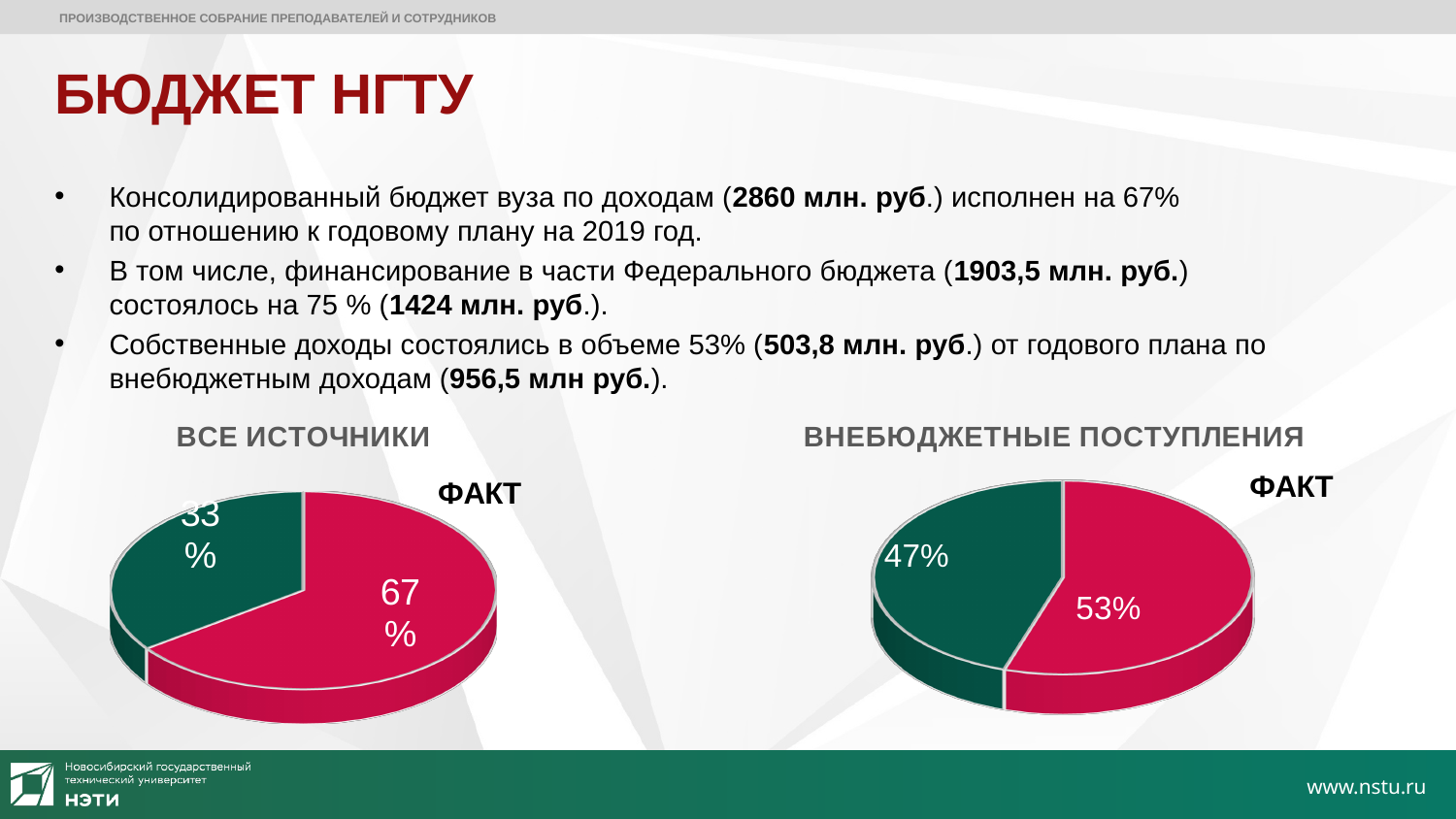
In the "ВСЕ ИСТОЧНИКИ" pie chart, what is the difference between the red slice and the green slice? 34% In the "ВСЕ ИСТОЧНИКИ" pie chart, what share is shown for the green slice? 33% What kind of chart is shown under the heading "ВНЕБЮДЖЕТНЫЕ ПОСТУПЛЕНИЯ"? pie chart In the "ВНЕБЮДЖЕТНЫЕ ПОСТУПЛЕНИЯ" pie chart, what share is shown for the green slice? 47% How many slices does the "ВСЕ ИСТОЧНИКИ" pie chart have? 2 How many slices does the "ВНЕБЮДЖЕТНЫЕ ПОСТУПЛЕНИЯ" pie chart have? 2 In the "ВНЕБЮДЖЕТНЫЕ ПОСТУПЛЕНИЯ" pie chart, what is the difference between the red slice and the green slice? 6% What legend label is shown next to the red slice in both pie charts? ФАКТ In the "ВСЕ ИСТОЧНИКИ" pie chart, what share is shown for the red "ФАКТ" slice? 67% What kind of chart is shown under the heading "ВСЕ ИСТОЧНИКИ"? pie chart In the "ВСЕ ИСТОЧНИКИ" pie chart, which slice is larger, the red one or the green one? the red one